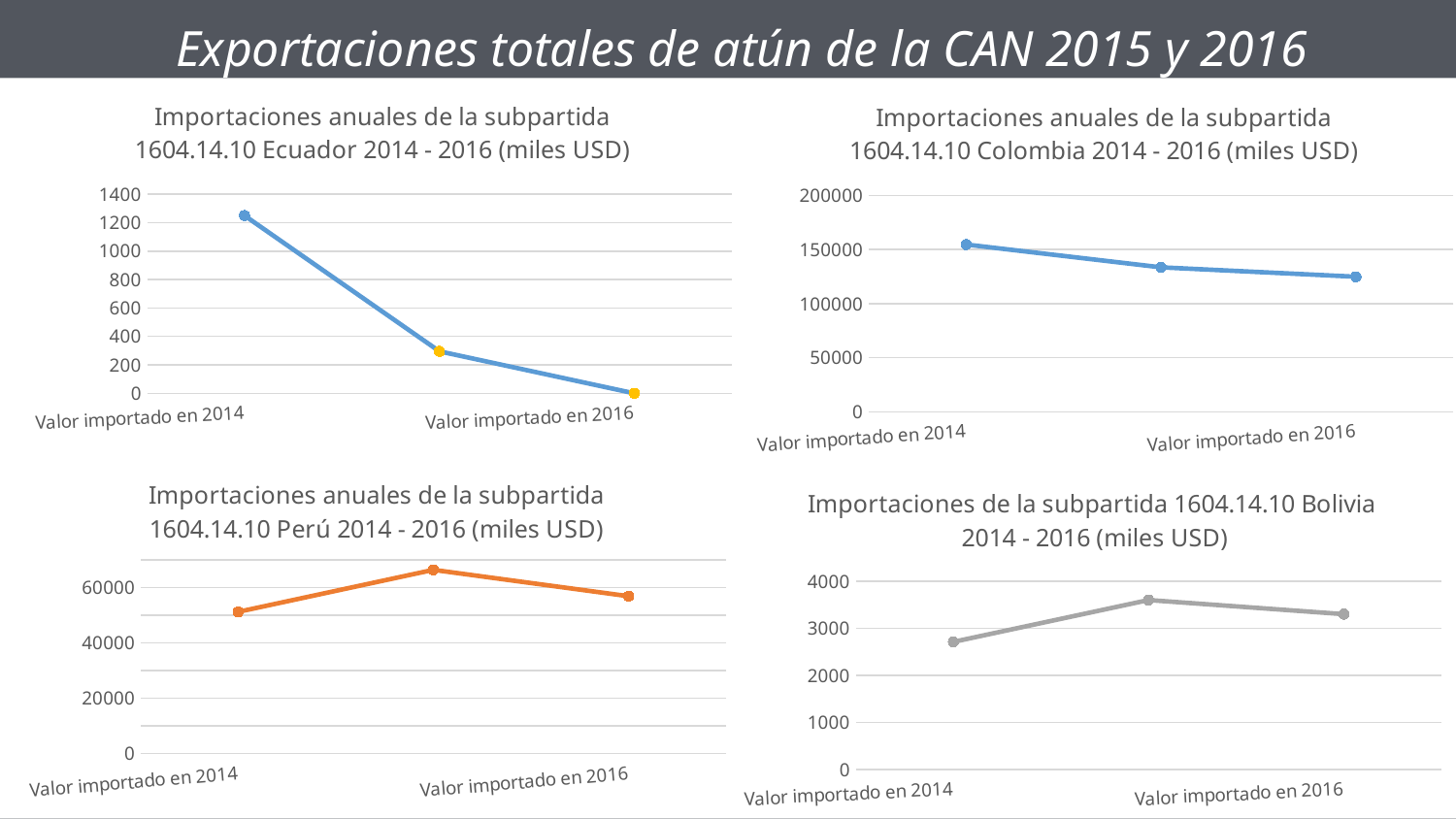
In the Ecuador chart (top left), do the values rise or fall from 2014 to 2016? fall How many charts are shown on the slide? 4 In the Colombia chart (top right), do the values rise or fall from 2014 to 2016? fall In the Ecuador chart (top left), is the value for 'Valor importado en 2016' greater or less than 200? less In the Bolivia chart (bottom right), is the value for 'Valor importado en 2014' greater or less than 3000? less In the Colombia chart (top right), which point has the highest value? Valor importado en 2014 In the Perú chart (bottom left), which point has the lowest value? Valor importado en 2014 What type of chart is used for the Ecuador chart (top left)? line chart In the Colombia chart (top right), is the value for 'Valor importado en 2016' greater or less than 150000? less How many data points are plotted in the Bolivia chart (bottom right)? 3